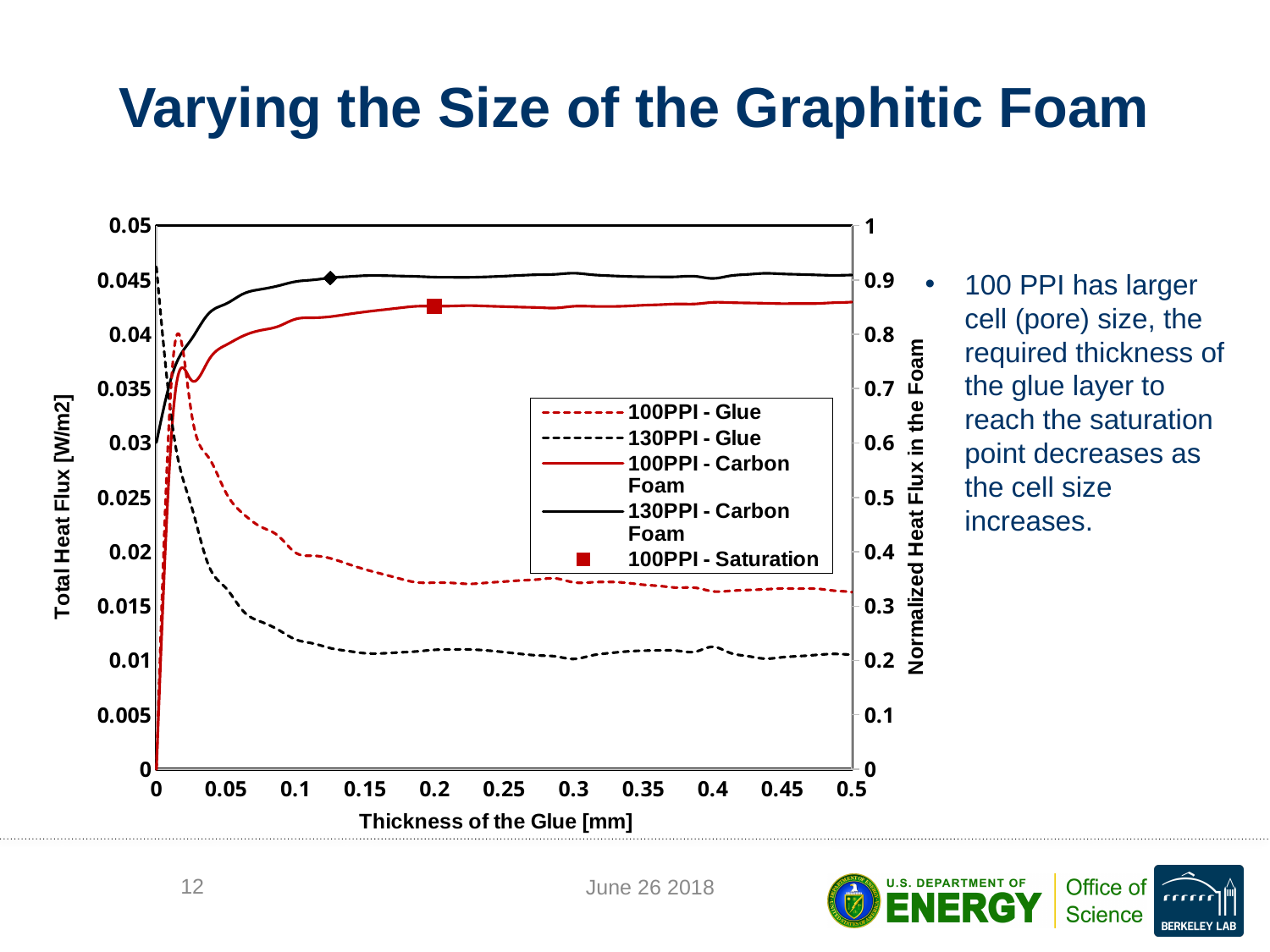
What is the title of the x axis? Thickness of the Glue [mm] Which series has the highest value at a glue thickness of 0.5 mm? 130PPI - Carbon Foam What is the title of the right-hand y axis? Normalized Heat Flux in the Foam Between 0 and 0.1 mm glue thickness, does the 130PPI - Carbon Foam curve rise or fall? rise What kind of chart is shown on the slide? line chart Which series has the lowest value at a glue thickness of 0.5 mm? 130PPI - Glue At a glue thickness of 0.3 mm, which is higher: 100PPI - Carbon Foam or 130PPI - Carbon Foam? 130PPI - Carbon Foam Beyond a glue thickness of 0.05 mm, does the 100PPI - Glue curve rise or fall as thickness increases? fall Is the normalized heat flux for 100PPI - Carbon Foam at 0.4 mm greater or less than 0.8? greater How many series does the legend list? 5 At a glue thickness of 0.3 mm, which is higher: 100PPI - Glue or 130PPI - Glue? 100PPI - Glue Is the total heat flux for 100PPI - Glue at 0.5 mm greater or less than 0.02 W/m2? less